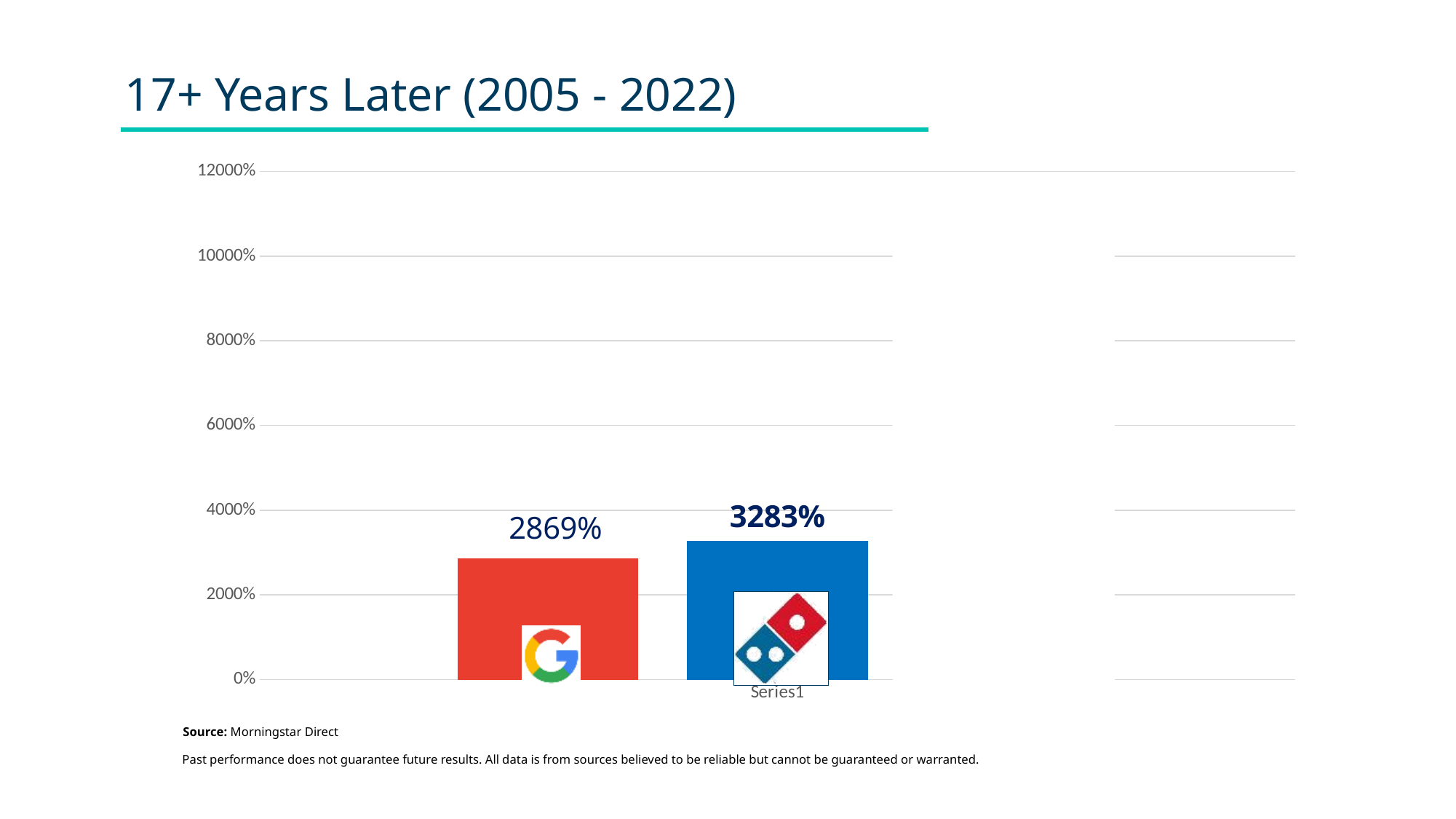
How many bars are plotted on the chart? 2 Which bar has the lowest value on the chart? The red (Google) bar Is the value for the blue (Domino's) bar greater or less than 2000%? greater What kind of chart is shown on the slide? Bar chart Is the value for the red (Google) bar larger or smaller than the value for the blue (Domino's) bar? Smaller What value is labelled on the red bar with the Google logo? 2869% Which bar has the highest value, the red (Google) bar or the blue (Domino's) bar? The blue (Domino's) bar What source is cited for the chart data? Morningstar Direct What is the title of the slide? 17+ Years Later (2005 - 2022) What value is labelled on the blue bar with the Domino's logo? 3283% Is the value for the red (Google) bar greater or less than 4000%? less What is the difference between the blue (Domino's) bar value and the red (Google) bar value? 414%